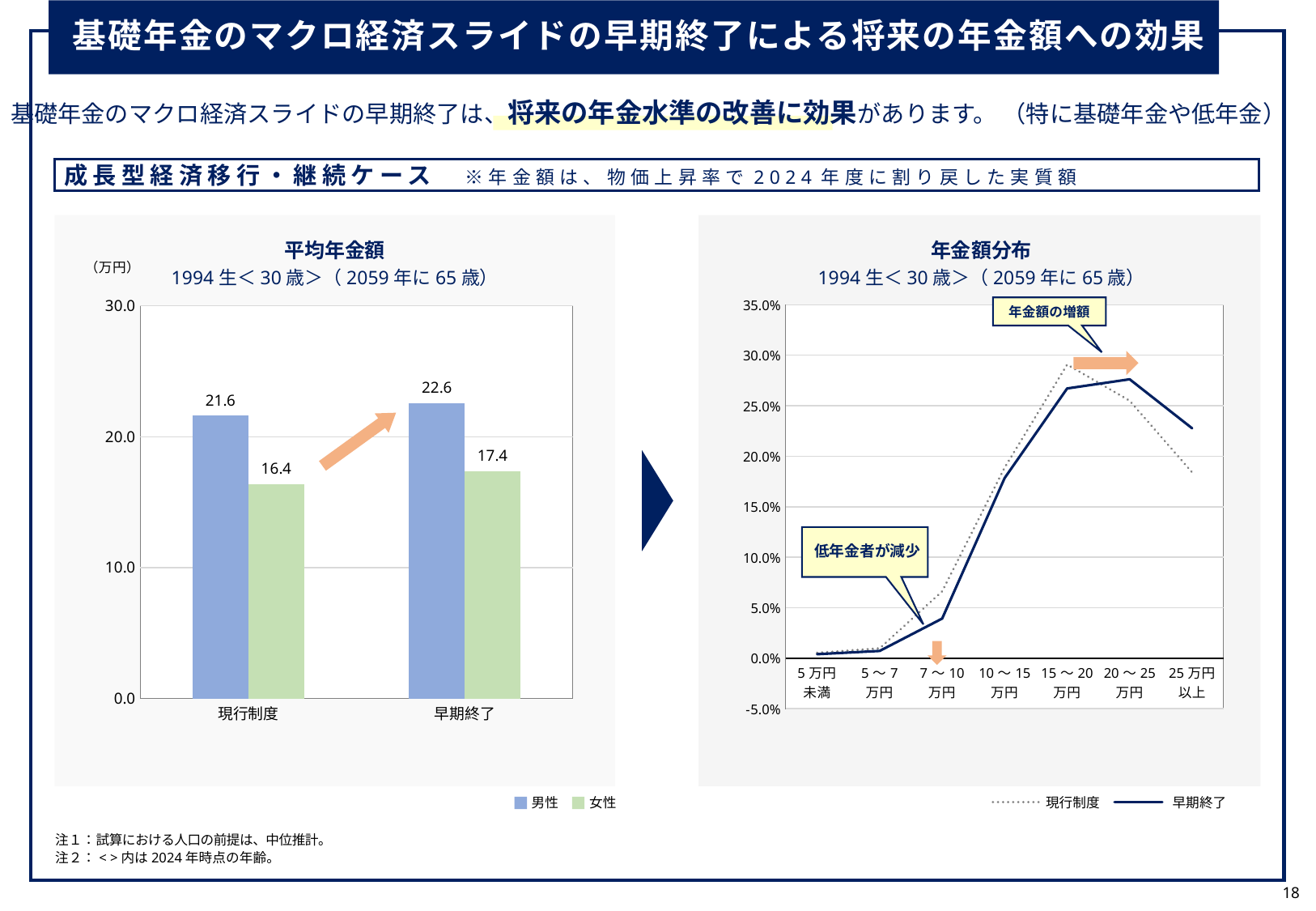
In the 平均年金額 chart, what is the value for 女性 under 早期終了? 17.4 In the 平均年金額 chart, what is the value for 男性 under 現行制度? 21.6 In the 平均年金額 chart, what is the value for 女性 under 現行制度? 16.4 In the 平均年金額 chart, which bar is the highest? 男性 under 早期終了 (22.6) What kind of chart is the 年金額分布 chart on the right? Line chart In the 平均年金額 chart, which bar is the lowest? 女性 under 現行制度 (16.4) What kind of chart is the 平均年金額 chart on the left? Bar chart In the 平均年金額 chart, what is the difference between the 男性 values for 早期終了 and 現行制度? 1.0 In the 平均年金額 chart, what is the difference between 男性 and 女性 under 早期終了? 5.2 In the 年金額分布 chart, is the 早期終了 value for 15～20万円 greater or less than 25.0%? greater In the 年金額分布 chart, how many categories are shown on the x axis? 7 In the 平均年金額 chart, how many series does the legend list? 2